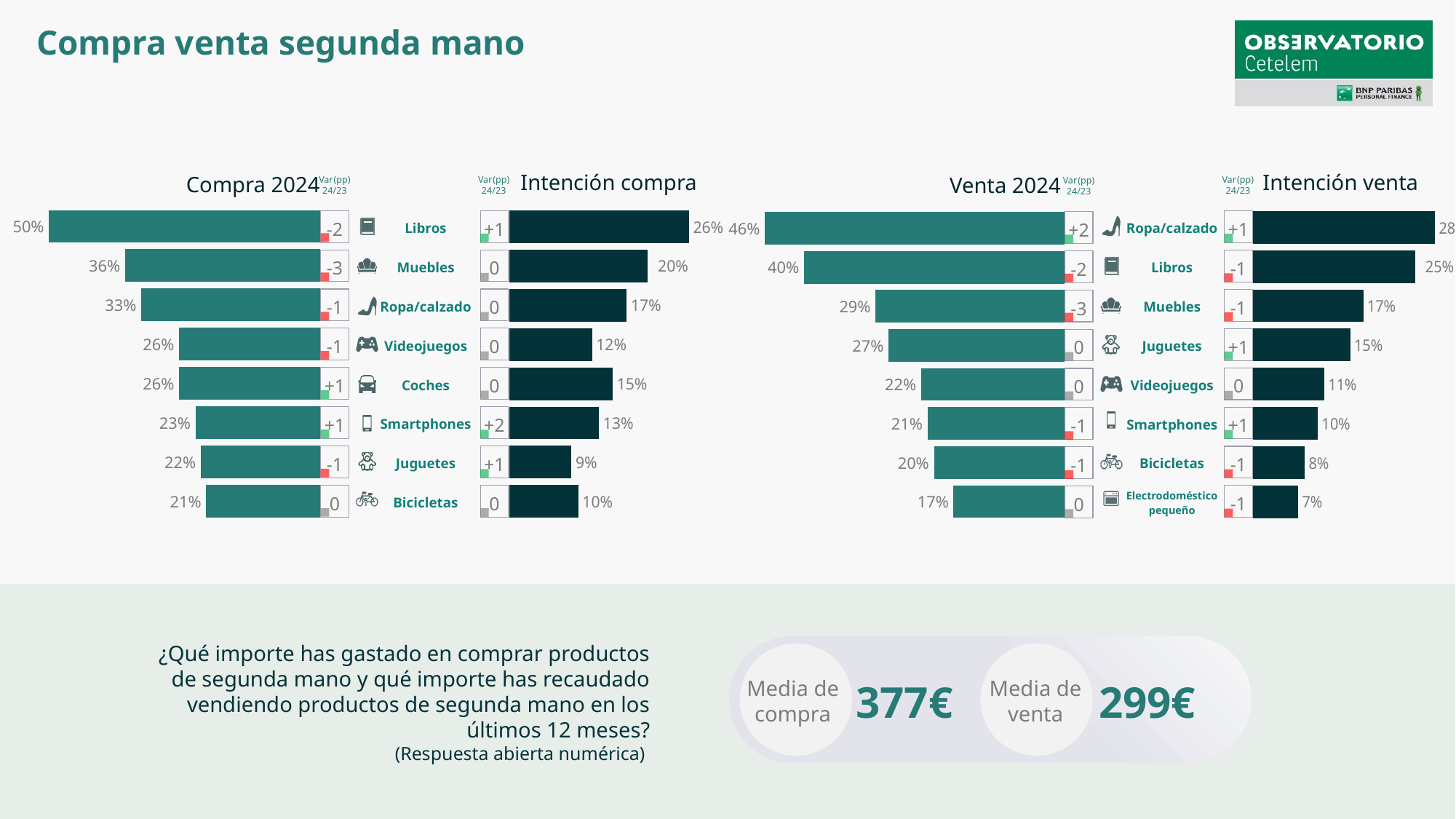
In the Intención venta chart, what is the value for Libros? 25% What kind of chart is the Compra 2024 chart? Bar chart In the Compra 2024 chart, what is the value for Libros? 50% In the Intención venta chart, which category has the lowest value? Electrodoméstico pequeño In the Compra 2024 chart, what is the difference between Libros and Muebles? 14 percentage points In the Venta 2024 chart, what is the value for Juguetes? 27% In the Venta 2024 chart, what is the Var(pp) 24/23 shown for Muebles? -3 How many categories are shown in the Venta 2024 chart? 8 In the Intención compra chart, which is larger, Juguetes or Bicicletas? Bicicletas In the Venta 2024 chart, which category has the highest value? Ropa/calzado In the Compra 2024 chart, which category has the lowest value? Bicicletas In the Intención compra chart, what is the value for Coches? 15%